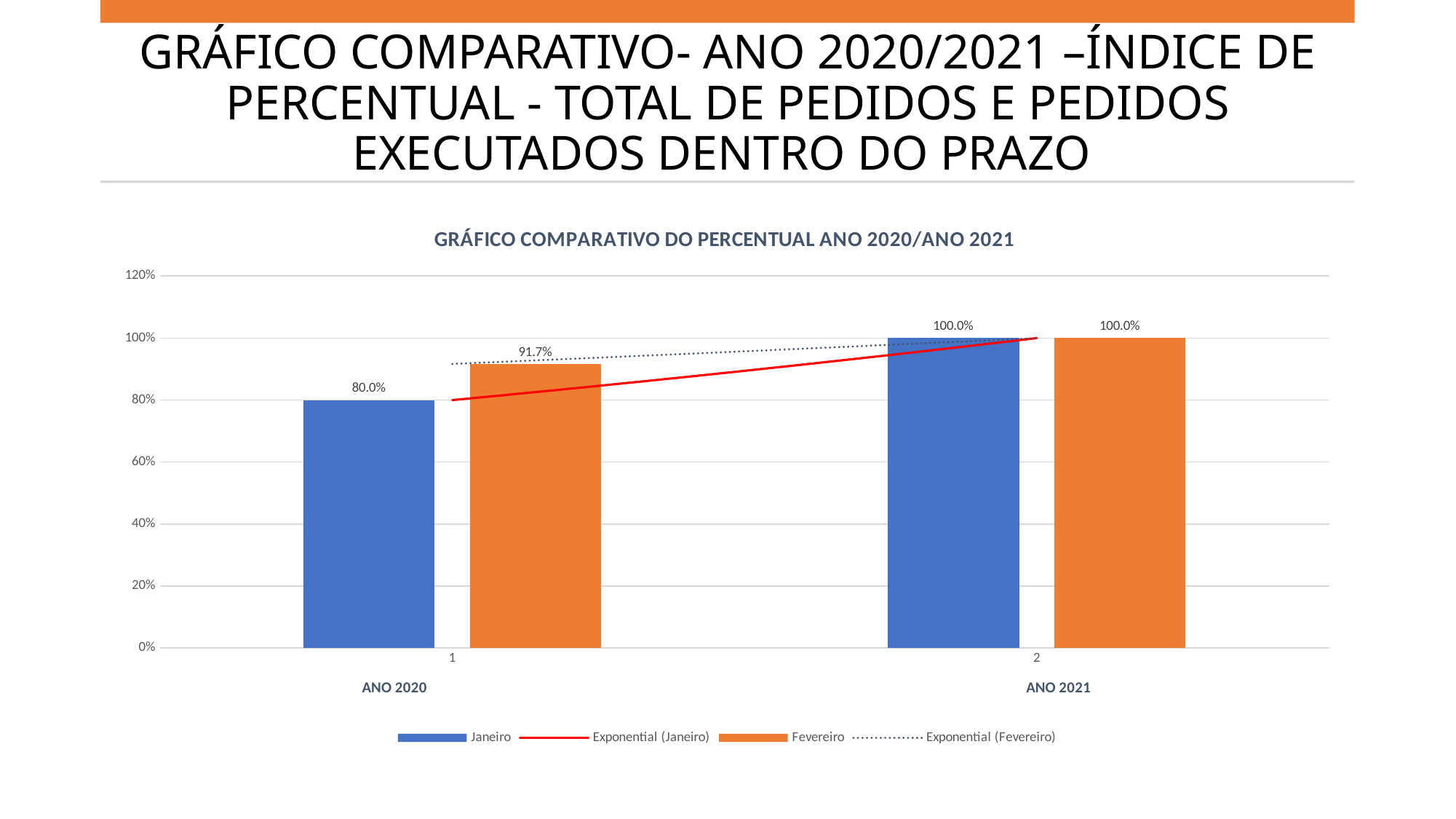
How many entries does the legend list? 4 What kind of chart is shown on the slide? Bar chart What is the difference between the Janeiro value in ANO 2021 and the Janeiro value in ANO 2020? 20.0% What is the difference between the Fevereiro and Janeiro values in ANO 2020? 11.7% What is the value for Janeiro in ANO 2021? 100.0% What is the value for Fevereiro in ANO 2020? 91.7% In ANO 2020, which is larger, the Janeiro value or the Fevereiro value? Fevereiro Which bar has the lowest value on the chart? Janeiro, ANO 2020 Is the value for Fevereiro in ANO 2020 greater or less than 80%? greater How many year categories are shown on the x axis? 2 What is the value for Fevereiro in ANO 2021? 100.0% What is the value for Janeiro in ANO 2020? 80.0%